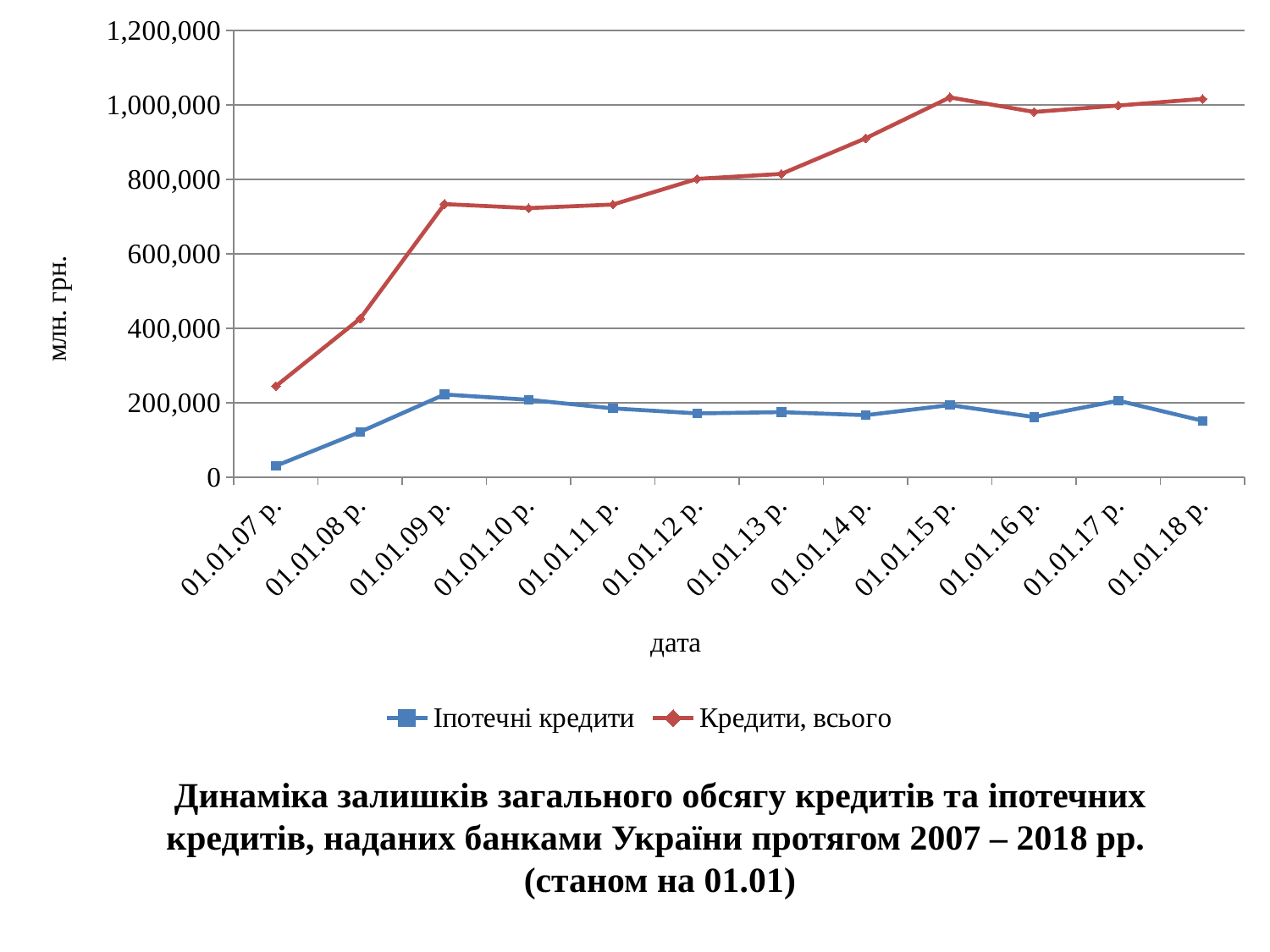
Is the value for Кредити, всього at 01.01.14 р. greater or less than 800,000? greater How many dates are plotted along the x axis? 12 On which date is the value for Кредити, всього lowest? 01.01.07 р. Is the value for Іпотечні кредити at 01.01.18 р. greater or less than 200,000? less What kind of chart is shown on the slide? line chart How many series does the legend list? 2 Is the value for Кредити, всього at 01.01.09 р. greater or less than 600,000? greater On which date is the value for Іпотечні кредити highest? 01.01.09 р. Which is larger for Кредити, всього: the value at 01.01.11 р. or at 01.01.12 р.? 01.01.12 р. Does the Кредити, всього series generally rise or fall from 01.01.07 р. to 01.01.18 р.? rise On which date is the value for Іпотечні кредити lowest? 01.01.07 р.